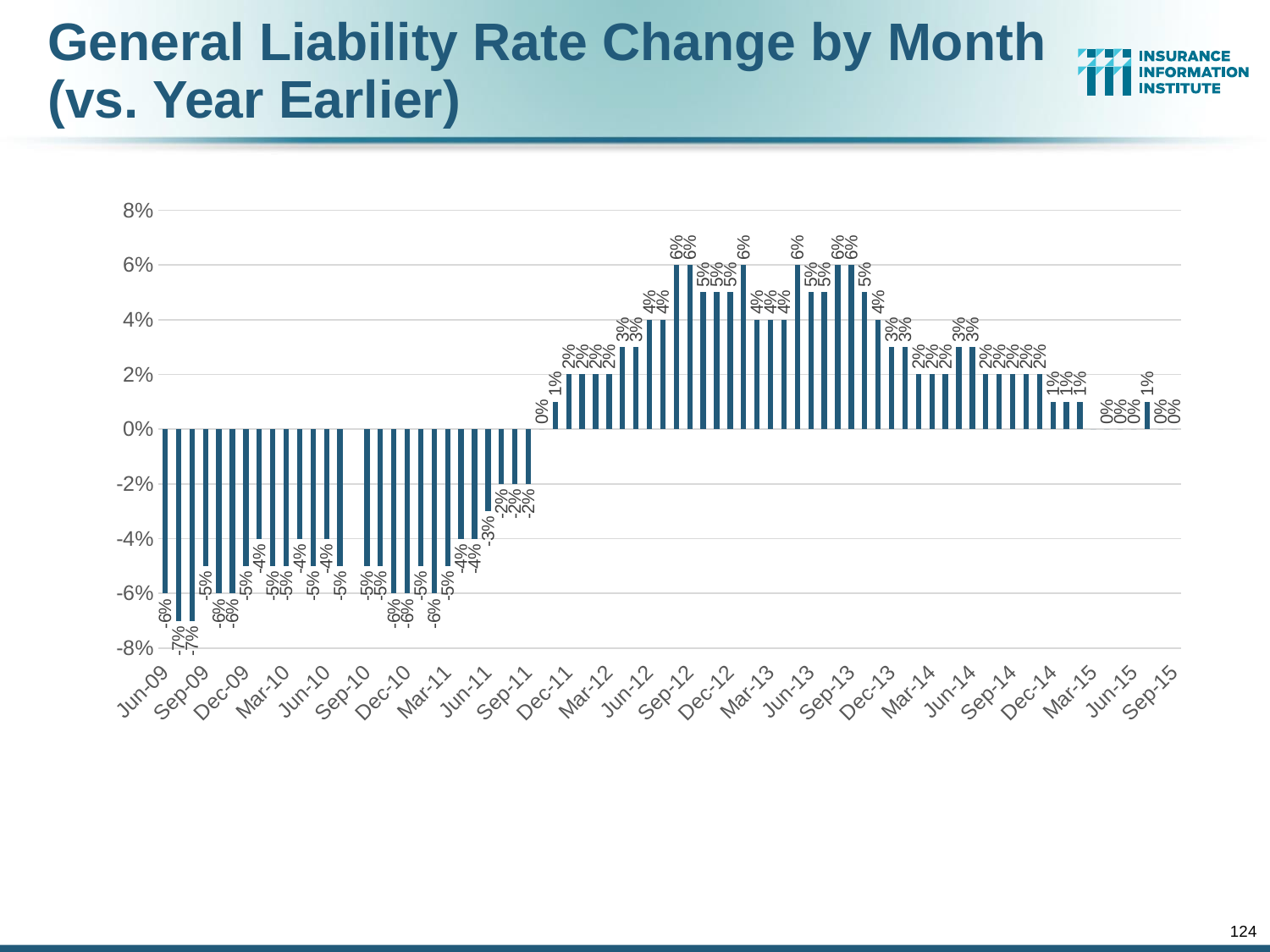
What is the highest rate change value shown in the chart? 6% Is the value for Jun-09 greater or less than 0%? less What is the title of the chart? General Liability Rate Change by Month (vs. Year Earlier) What kind of chart is shown on the slide? Bar chart What is the highest value shown on the y axis? 8% Do the values generally rise or fall from Jun-09 to Sep-12? rise How many month labels are shown on the x axis? 26 Which is larger, the rate change for Jun-09 or for Sep-15? Sep-15 What is the rate change for Sep-15, the last bar in the chart? 0% What is the lowest rate change value shown in the chart? -7% What is the difference between the highest value (6%) and the lowest value (-7%) in the chart? 13 percentage points What is the rate change for Jun-09, the first bar in the chart? -6%